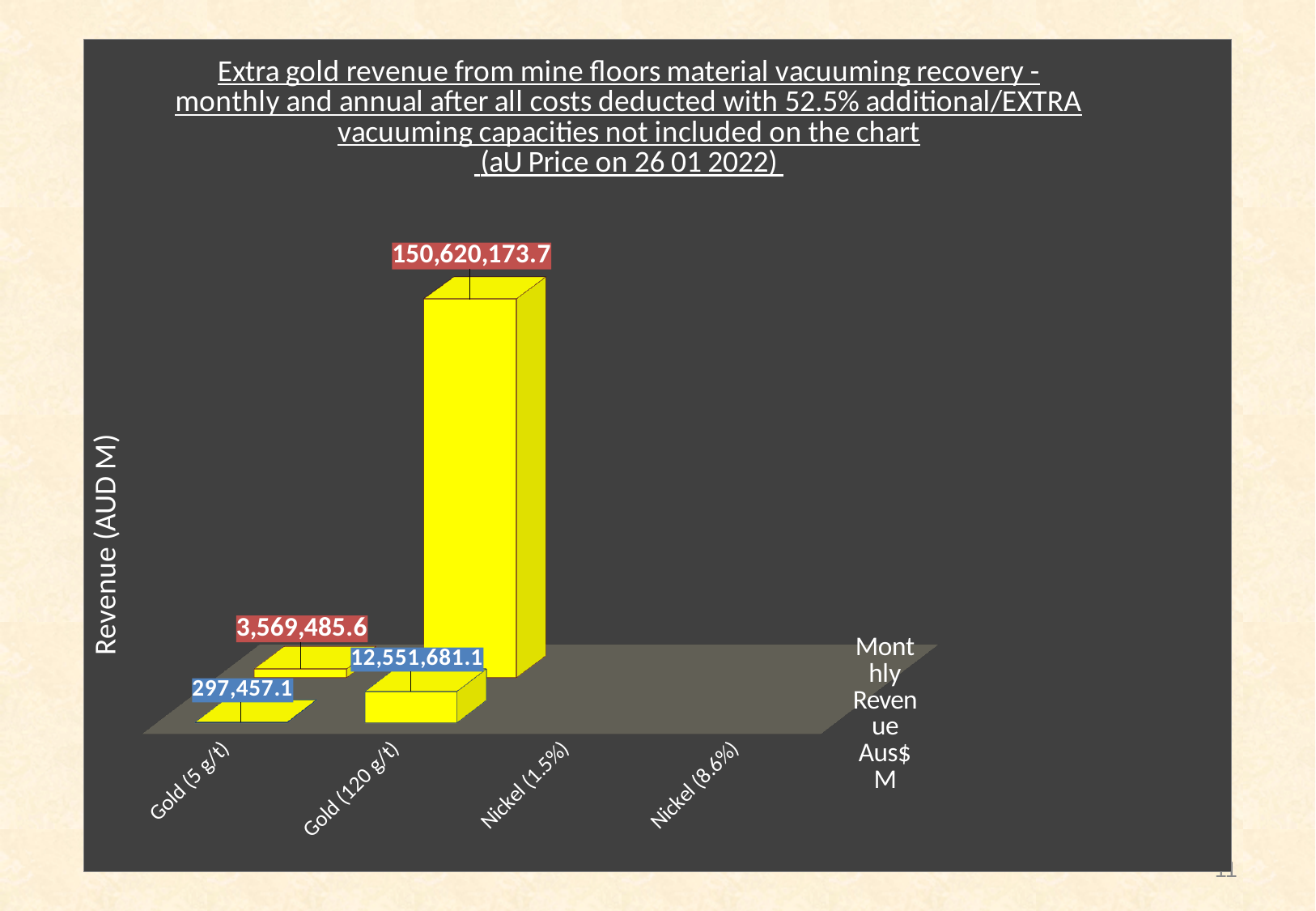
Which category has the tallest bar on the chart? Gold (120 g/t) How many categories are listed along the x axis of the chart? 4 How many of the x-axis categories have visible bars plotted? 2 What value is shown on the red label for the back-row bar of Gold (5 g/t)? 3,569,485.6 Which is larger: the Monthly Revenue Aus$ M value for Gold (120 g/t) or the red-labelled value for Gold (5 g/t)? Monthly Revenue Aus$ M for Gold (120 g/t) What is the Monthly Revenue Aus$ M value (blue label) for Gold (5 g/t)? 297,457.1 What value is shown on the red label for the back-row bar of Gold (120 g/t)? 150,620,173.7 What is the Monthly Revenue Aus$ M value (blue label) for Gold (120 g/t)? 12,551,681.1 What is the difference between the red-labelled values for Gold (120 g/t) and Gold (5 g/t)? 147,050,688.1 What is the difference between the Monthly Revenue Aus$ M values for Gold (120 g/t) and Gold (5 g/t)? 12,254,224.0 What kind of chart is shown on the slide? Bar chart What is the title of the vertical axis of the chart? Revenue (AUD M)